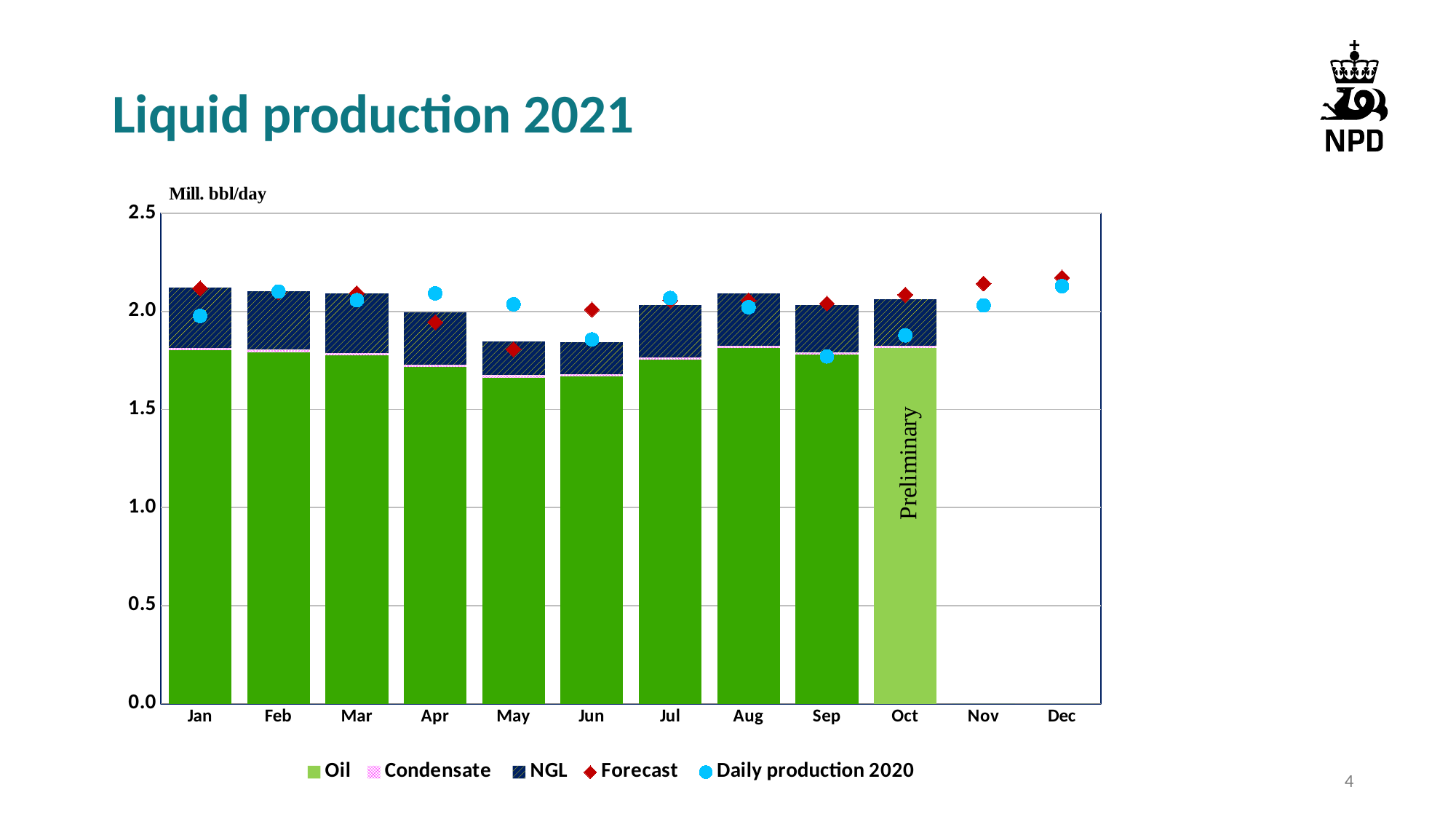
How many months are labelled on the x axis? 12 Is the Forecast marker for Dec greater or less than 2.0? greater Is the total stacked bar for Jan greater or less than 2.0? greater Which is larger, the total stacked bar for Jan or for May? Jan What kind of chart is shown on the slide? combination bar and line chart (stacked bars with markers) Is the total stacked bar for May greater or less than 2.0? less How many series does the legend list? 5 Which month's bar is labelled "Preliminary"? Oct Do the total stacked bars rise or fall from Jan to May? fall How many months have a stacked bar plotted? 10